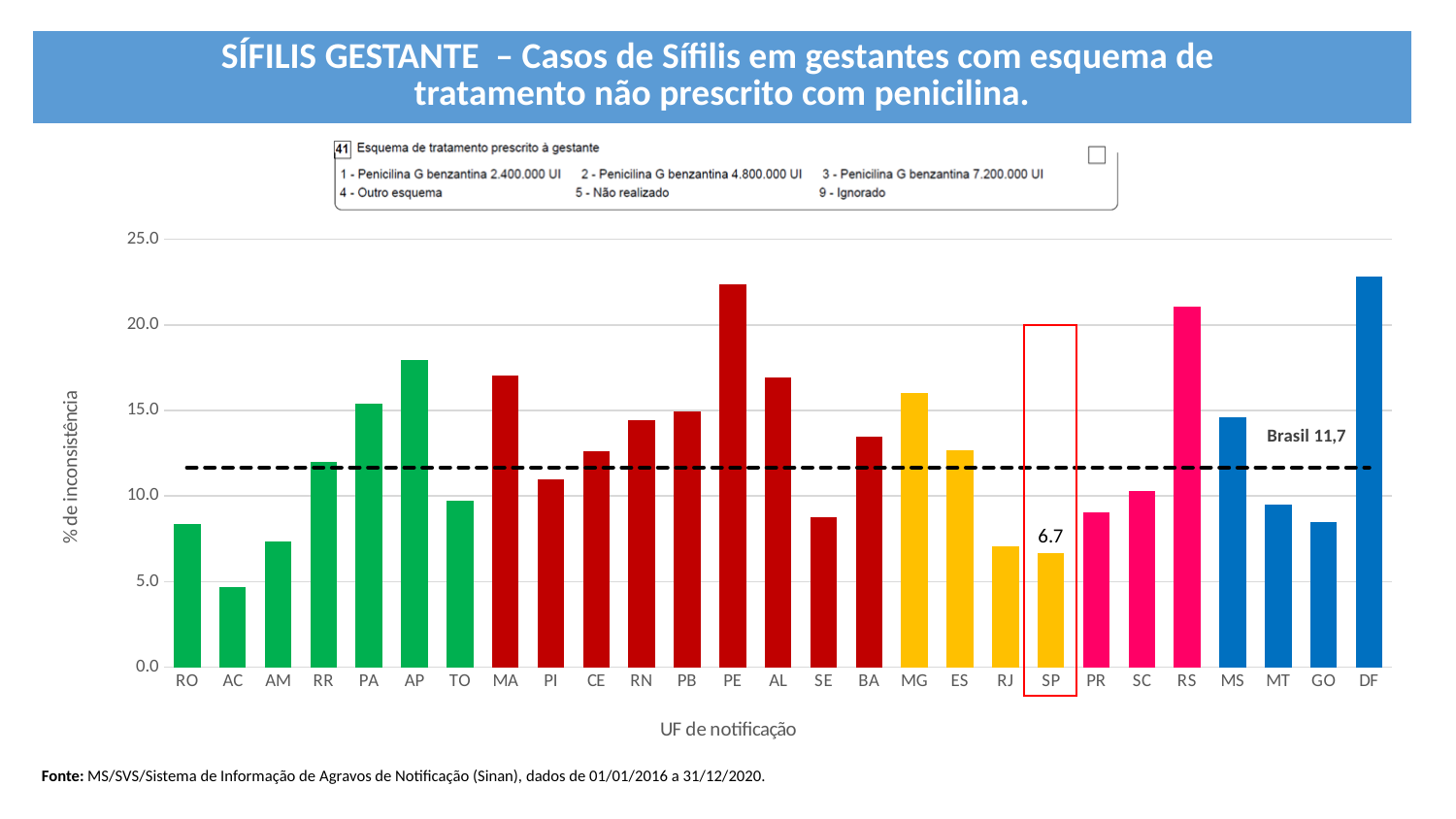
Is the value for AC greater or less than 5.0? less Which has a higher value, MS or MT? MS Is the value for PE greater or less than 20.0? greater Is the value for RS greater or less than 20.0? greater What value does the dashed reference line for Brasil represent? 11,7 What type of chart is shown on the slide? bar chart What is the value shown for SP? 6.7 Which UF has the lowest value in the chart? AC Which has a higher value, PA or AP? AP How many UFs (categories) are plotted on the x axis? 27 What is the title of the x axis? UF de notificação